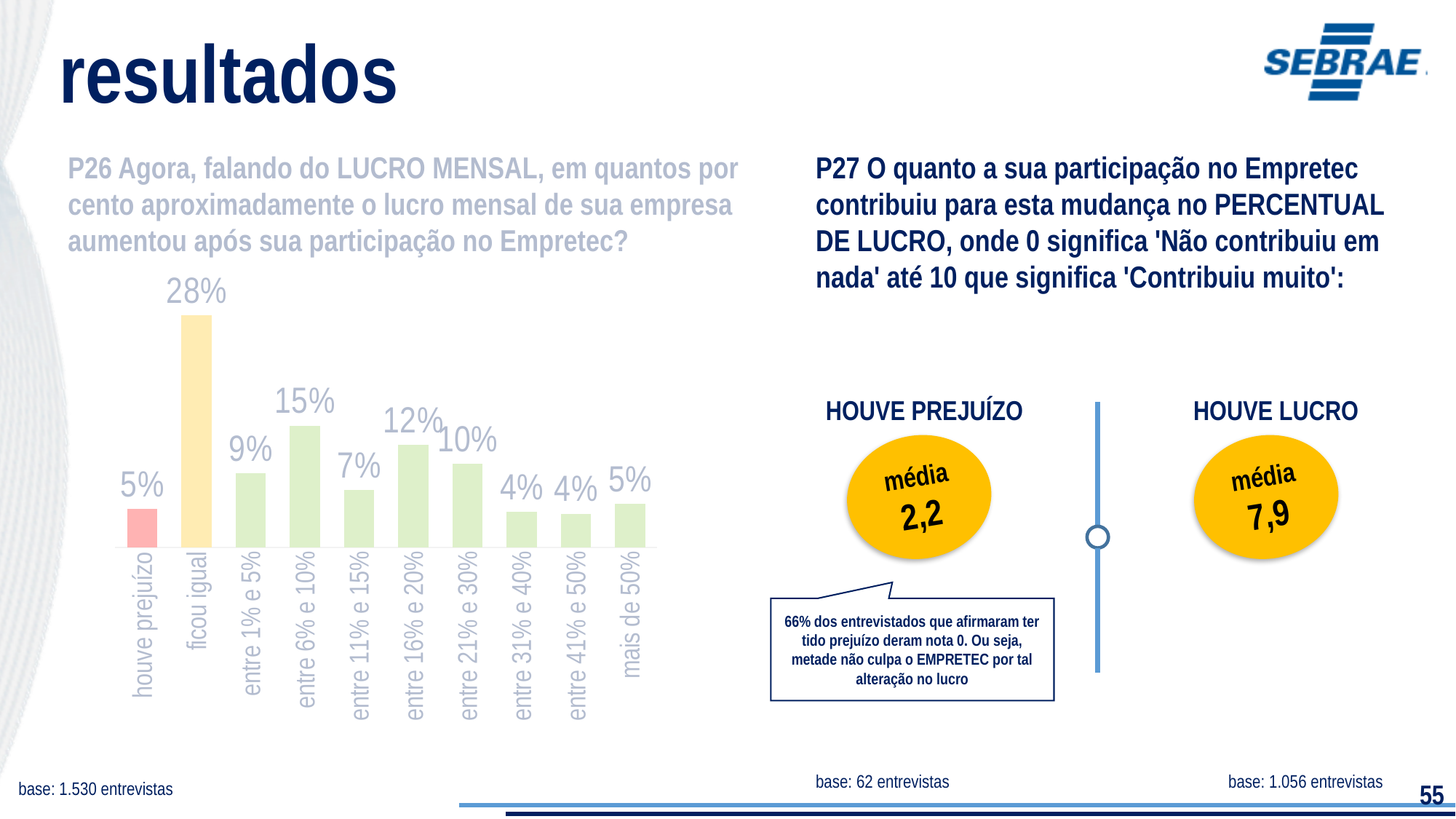
In the bar chart, what is the value for 'mais de 50%'? 5% What type of chart is shown on the left of the slide? bar chart In the bar chart, what is the value for 'houve prejuízo'? 5% In the bar chart, what is the value for 'entre 16% e 20%'? 12% How many categories does the bar chart on the left show? 10 In the bar chart, which is larger: 'entre 1% e 5%' or 'entre 11% e 15%'? entre 1% e 5% In the bar chart, what is the difference between 'entre 21% e 30%' and 'entre 31% e 40%'? 6% Which category has the highest value in the bar chart? ficou igual In the bar chart, what is the value for 'entre 6% e 10%'? 15% In the bar chart, what is the difference between 'ficou igual' and 'entre 6% e 10%'? 13% In the bar chart, which bar is coloured pink/red rather than green or yellow? houve prejuízo In the bar chart, what is the value for 'ficou igual'? 28%